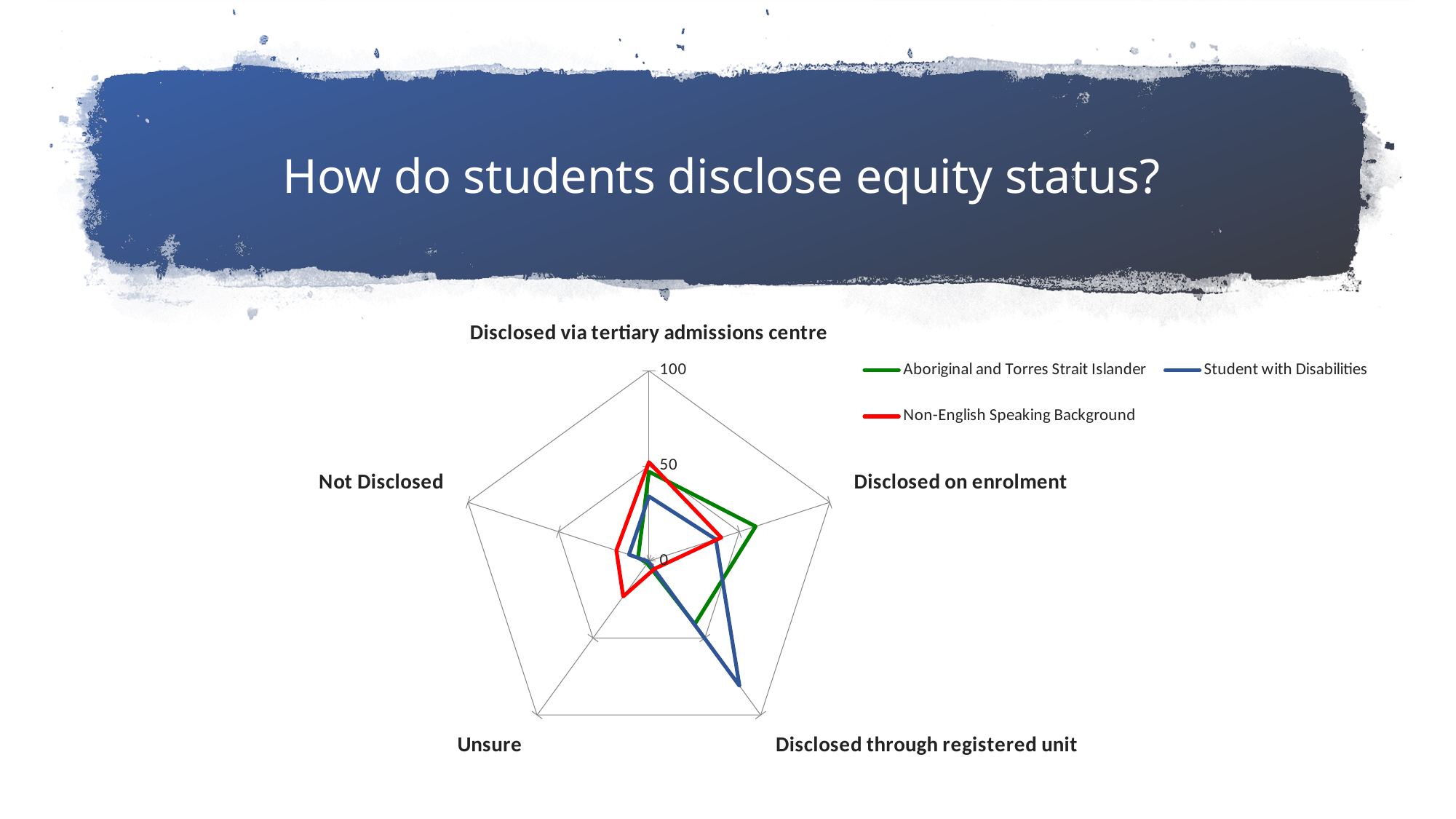
Which series has the highest value for "Disclosed on enrolment"? Aboriginal and Torres Strait Islander Is the value for Student with Disabilities on "Disclosed via tertiary admissions centre" greater or less than 50? less What colour is the line for the Non-English Speaking Background series? Red How many series does the legend list? 3 How many categories (axes) does the radar chart have? 5 Is the value for Student with Disabilities on "Disclosed through registered unit" greater or less than 50? greater For the Aboriginal and Torres Strait Islander series, which category has the highest value? Disclosed on enrolment For the Student with Disabilities series, which category has the highest value? Disclosed through registered unit Is the value for Non-English Speaking Background on "Disclosed through registered unit" greater or less than 50? less What kind of chart is shown on the slide? Radar chart For "Disclosed via tertiary admissions centre", which is larger: the Non-English Speaking Background value or the Student with Disabilities value? Non-English Speaking Background